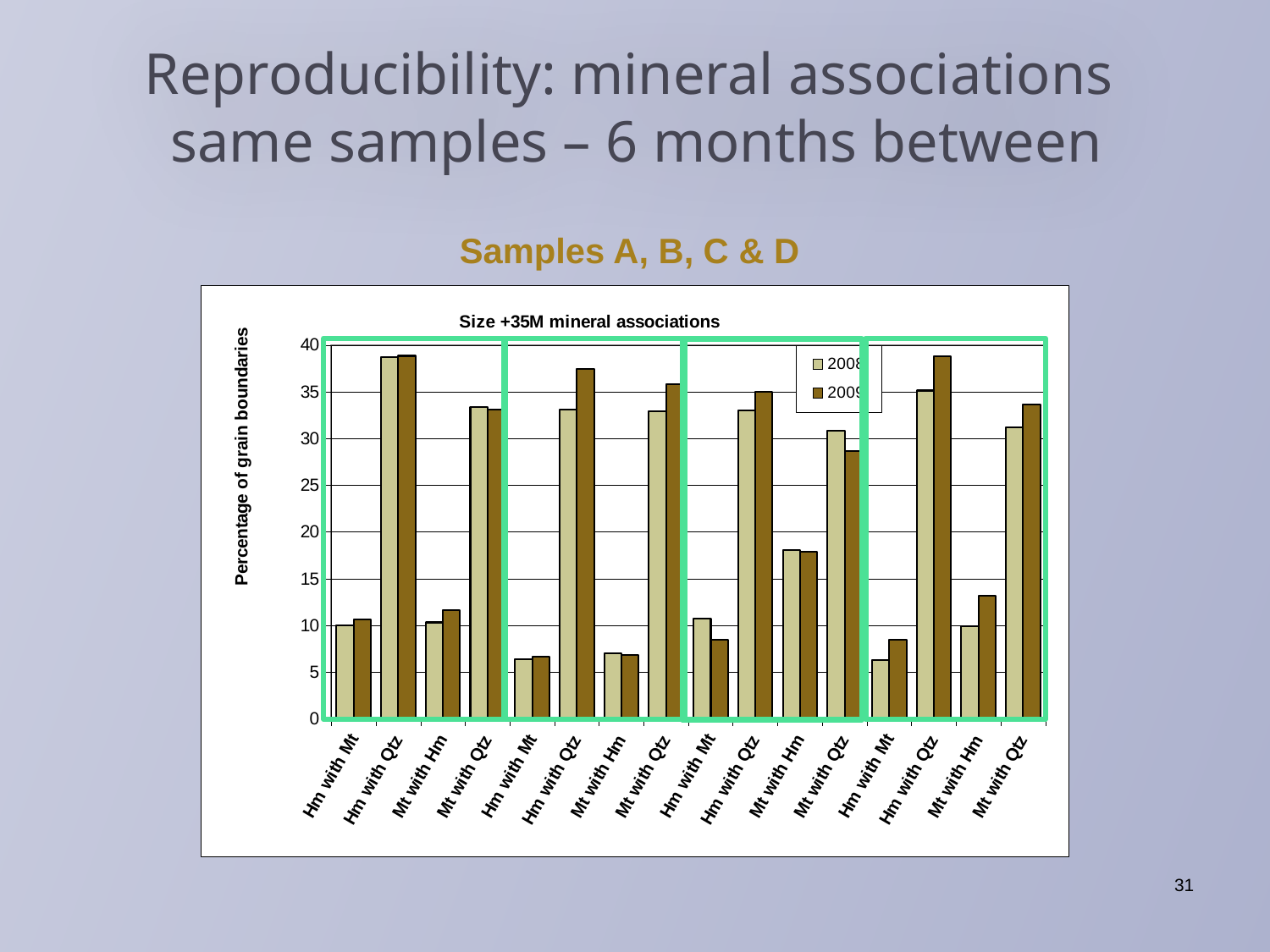
In the second group of four categories from the left, is the 2008 value for Hm with Mt greater or less than 10? less In the third group of four categories from the left, which series has the larger value for Mt with Qtz, 2008 or 2009? 2008 In the rightmost group of four categories, is the 2009 value for Mt with Hm greater or less than 10? greater What is the title of the chart? Size +35M mineral associations In the second group of four categories from the left, which series has the larger value for Hm with Qtz, 2008 or 2009? 2009 What is the label on the y axis of the chart? Percentage of grain boundaries In the leftmost group of four categories, is the 2008 value for Hm with Qtz greater or less than 35? greater How many categories are shown along the x axis of the chart? 16 What kind of chart is shown on the slide? bar chart How many series does the chart legend list? 2 In the third group of four categories from the left, which category has the lowest 2009 value? Hm with Mt